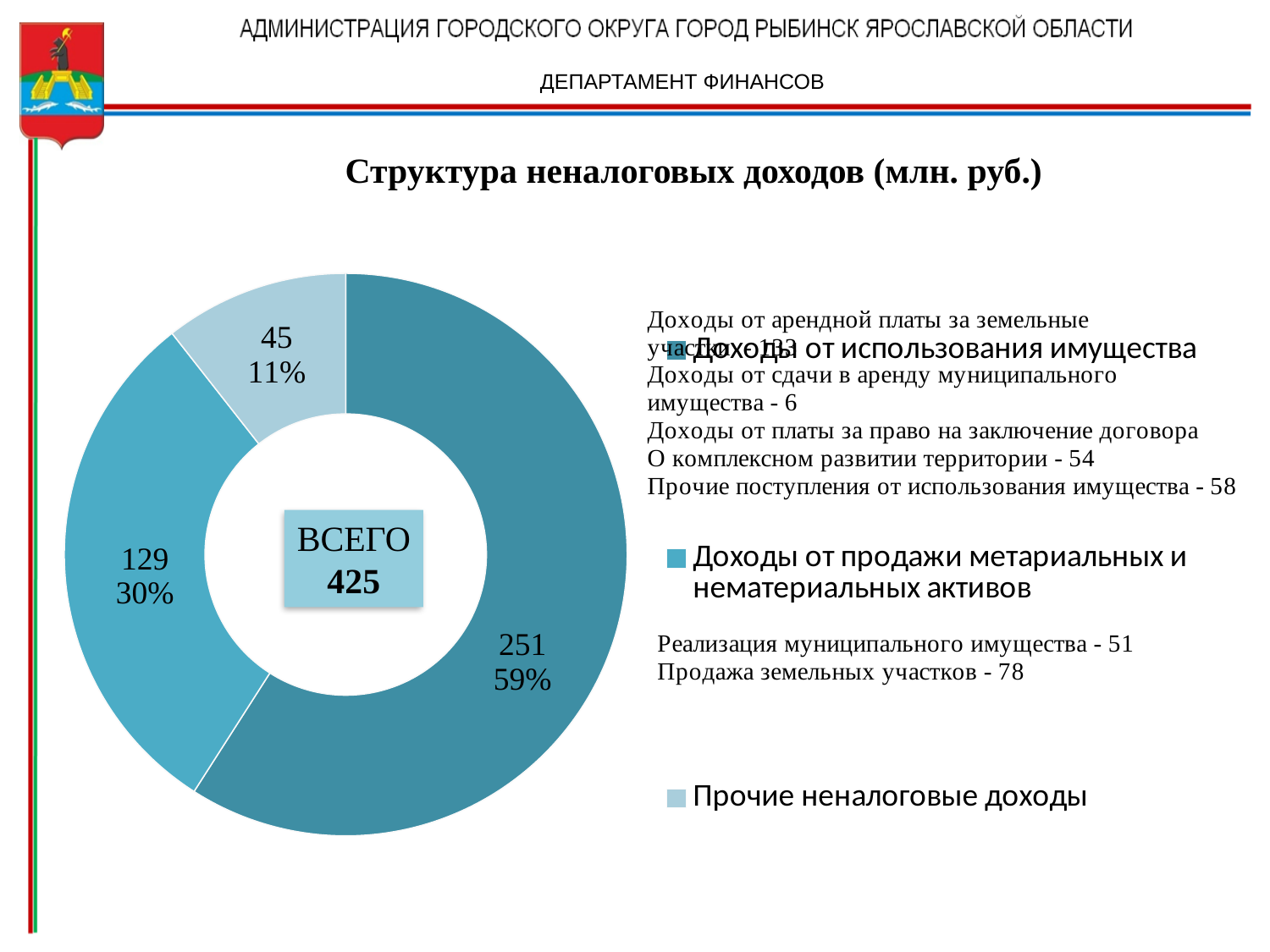
What is the title of the chart? Структура неналоговых доходов (млн. руб.) What kind of chart is shown on the slide? Doughnut (pie) chart What is the value for Прочие неналоговые доходы? 45 How many entries does the legend list? 3 What is the value for Доходы от использования имущества? 251 How many slices does the doughnut chart have? 3 Which category has the smallest slice? Прочие неналоговые доходы What is the value for Доходы от продажи метариальных и нематериальных активов? 129 What share of the total does Доходы от использования имущества represent? 59% What share of the total does Прочие неналоговые доходы represent? 11% Which category has the largest slice? Доходы от использования имущества What is the difference between the values for Доходы от использования имущества and Доходы от продажи метариальных и нематериальных активов? 122